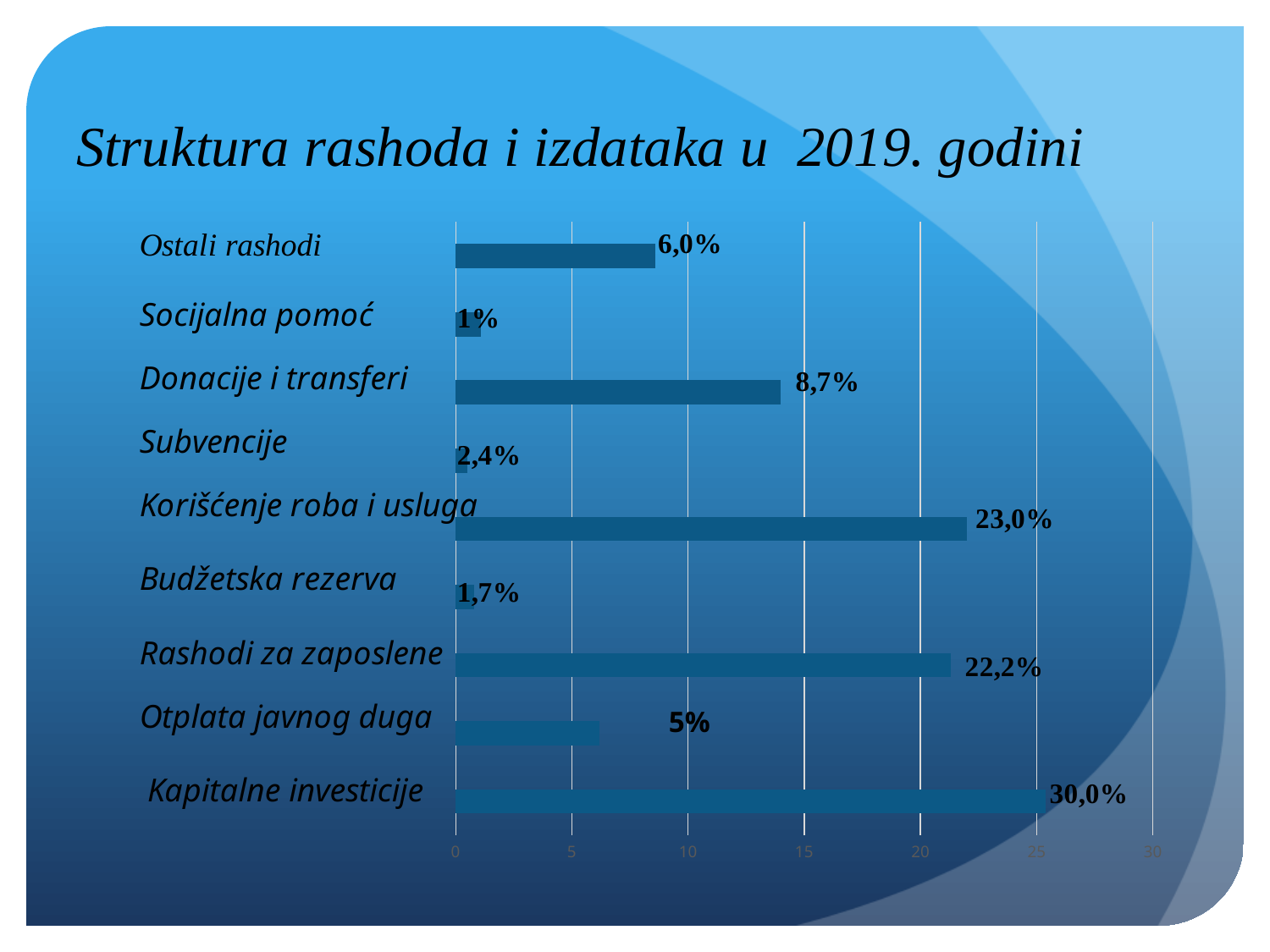
What is the title of the slide? Struktura rashoda i izdataka u 2019. godini What is the value for Donacije i transferi? 8,7% Which is larger, the value for Korišćenje roba i usluga or the value for Rashodi za zaposlene? Korišćenje roba i usluga Which category has the highest value? Kapitalne investicije What is the difference between the values for Kapitalne investicije and Korišćenje roba i usluga? 7,0 percentage points What is the difference between the values for Donacije i transferi and Ostali rashodi? 2,7 percentage points How many categories are shown in the chart? 9 What is the value for Korišćenje roba i usluga? 23,0% What kind of chart is shown on the slide? Bar chart What is the value for Kapitalne investicije? 30,0% What is the value for Budžetska rezerva? 1,7%